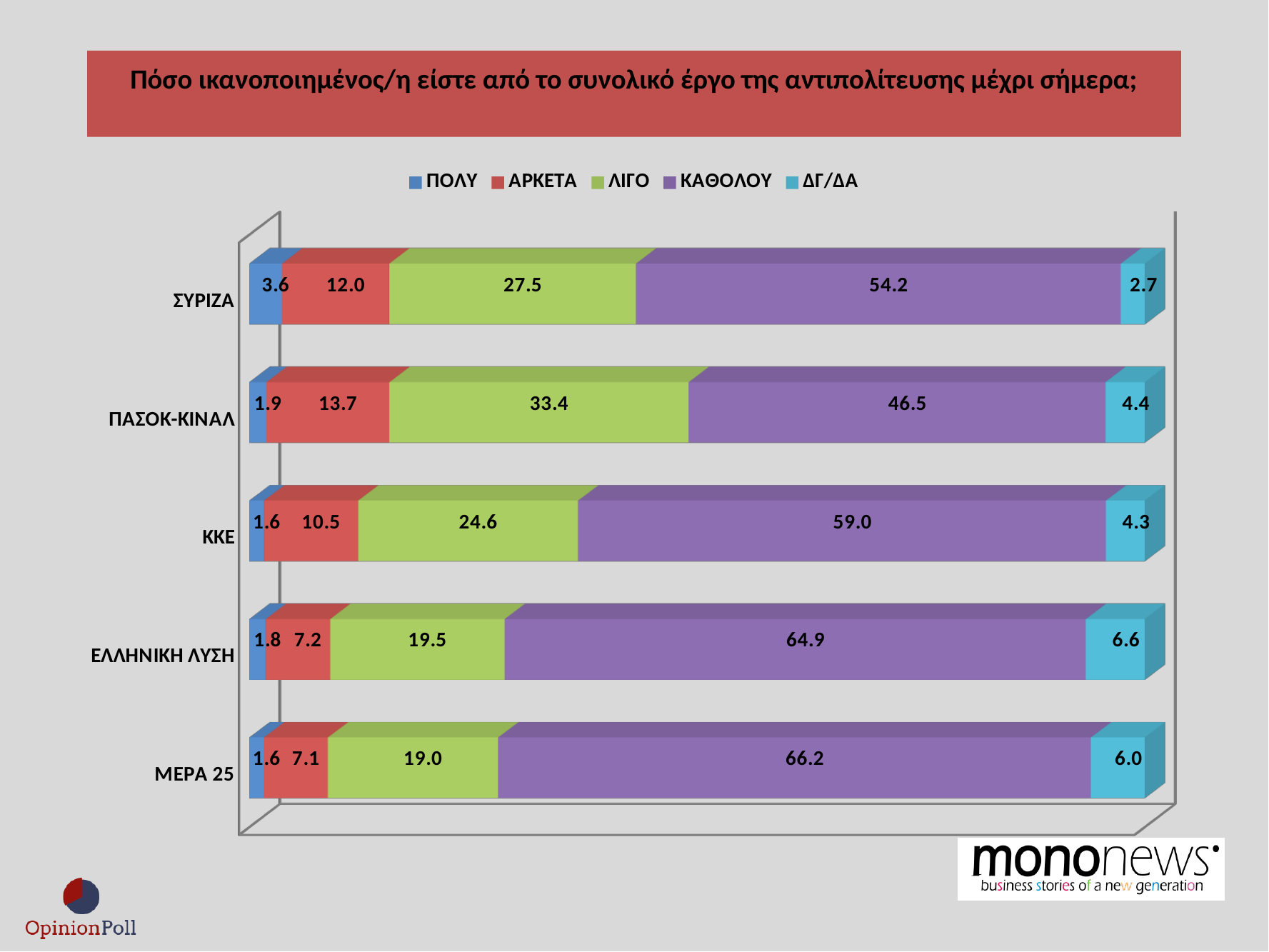
What is the total of the stacked bar for ΚΚΕ? 100.0 What is the ΚΑΘΟΛΟΥ value for ΣΥΡΙΖΑ? 54.2 What kind of chart is shown on the slide? stacked bar chart Which is larger, the ΠΟΛΥ value for ΣΥΡΙΖΑ or the ΠΟΛΥ value for ΠΑΣΟΚ-ΚΙΝΑΛ? ΣΥΡΙΖΑ Which legend entry is shown in purple? ΚΑΘΟΛΟΥ Which party has the highest ΚΑΘΟΛΟΥ value? ΜΕΡΑ 25 Which party has the lowest ΑΡΚΕΤΑ value? ΜΕΡΑ 25 What is the ΔΓ/ΔΑ value for ΕΛΛΗΝΙΚΗ ΛΥΣΗ? 6.6 How many series does the legend list? 5 What is the difference between the ΚΑΘΟΛΟΥ values for ΚΚΕ and ΣΥΡΙΖΑ? 4.8 What is the ΛΙΓΟ value for ΠΑΣΟΚ-ΚΙΝΑΛ? 33.4 How many parties (categories) are shown on the chart? 5